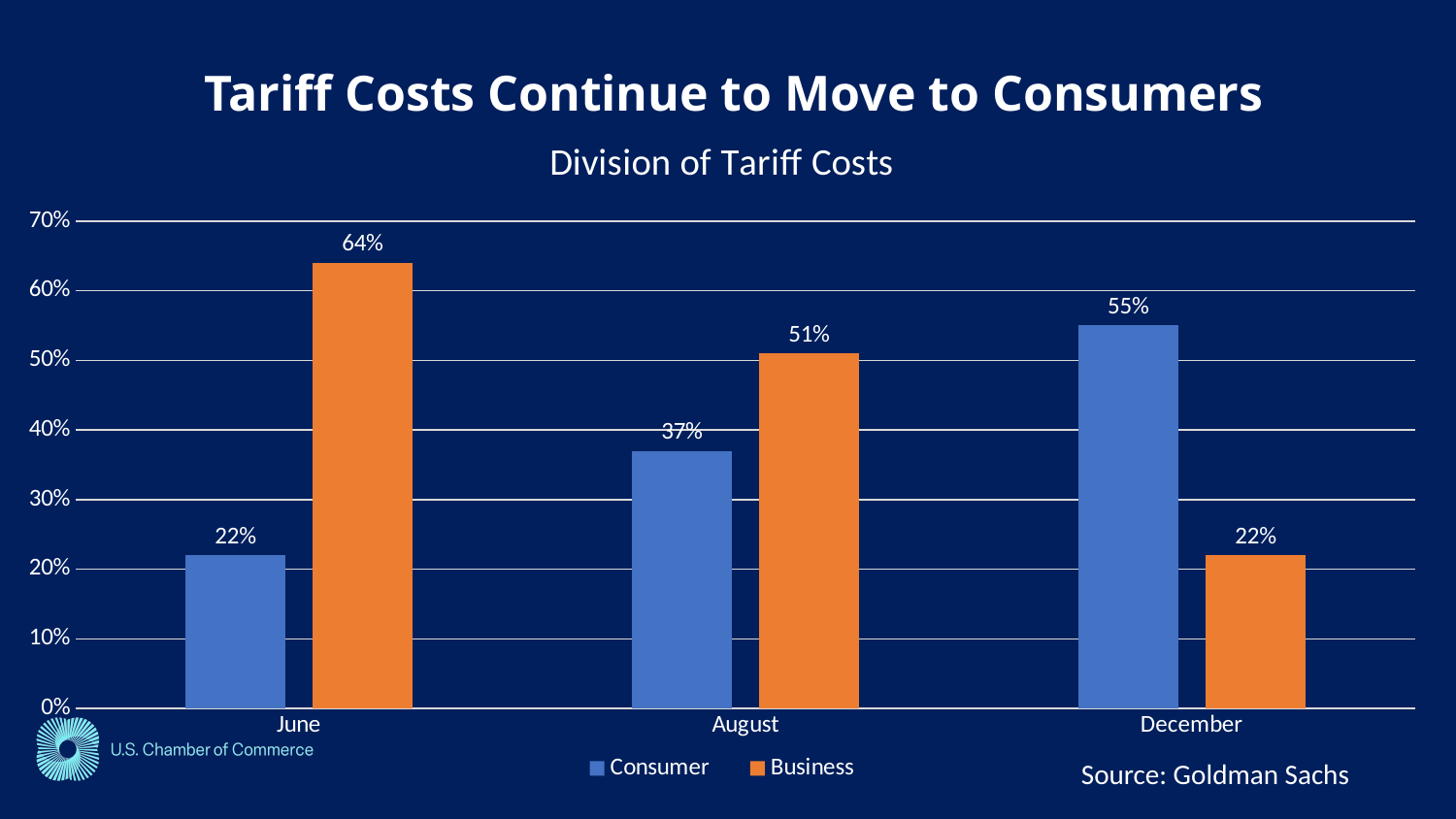
What kind of chart is shown on the slide? Bar chart What is the Consumer value for June? 22% Which is larger in August, the Consumer value or the Business value? Business What is the Consumer value for December? 55% In which month is the Business share highest? June How many months are shown on the x axis? 3 How many series does the legend list? 2 Is the Consumer value for August greater or less than 40%? less In which month is the Consumer share lowest? June Does the Consumer share rise or fall from June to December? Rise What is the difference between the Business and Consumer values in June? 42% What is the Business value for August? 51%